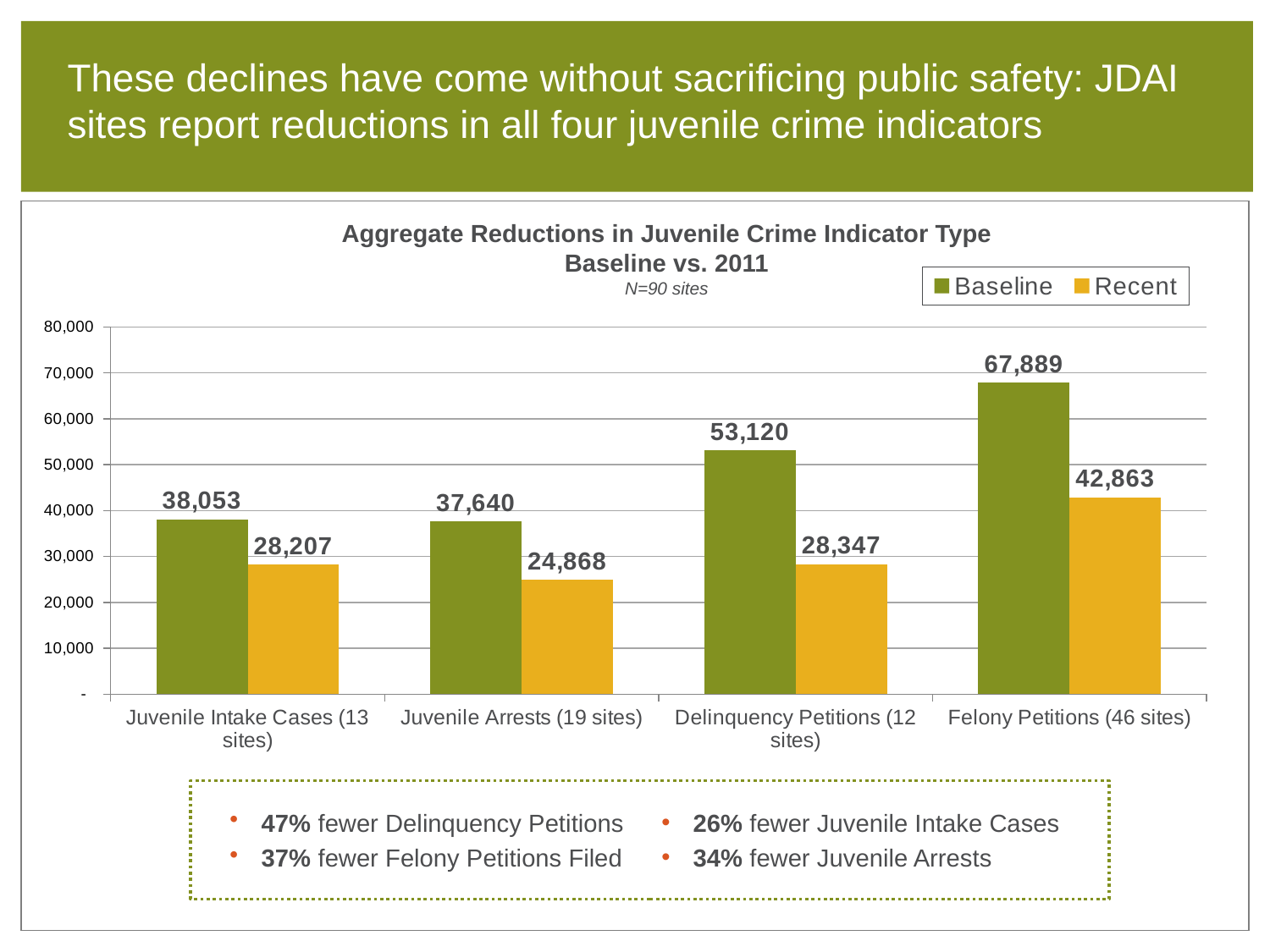
What is the Recent value for Juvenile Arrests (19 sites)? 24,868 How many series does the legend list? 2 What is the difference between the Baseline and Recent values for Felony Petitions (46 sites)? 25,026 What kind of chart is shown on the slide? Bar chart What is the Recent value for Delinquency Petitions (12 sites)? 28,347 Is the Recent value for Felony Petitions (46 sites) greater or less than 40,000? greater What is the difference between the Baseline and Recent values for Juvenile Intake Cases (13 sites)? 9,846 Which category has the lowest Recent value? Juvenile Arrests (19 sites) How many categories are shown on the x axis? 4 What is the Baseline value for Felony Petitions (46 sites)? 67,889 Which category has the highest Baseline value? Felony Petitions (46 sites) Which is larger, the Baseline value for Delinquency Petitions (12 sites) or the Baseline value for Juvenile Arrests (19 sites)? Delinquency Petitions (12 sites)